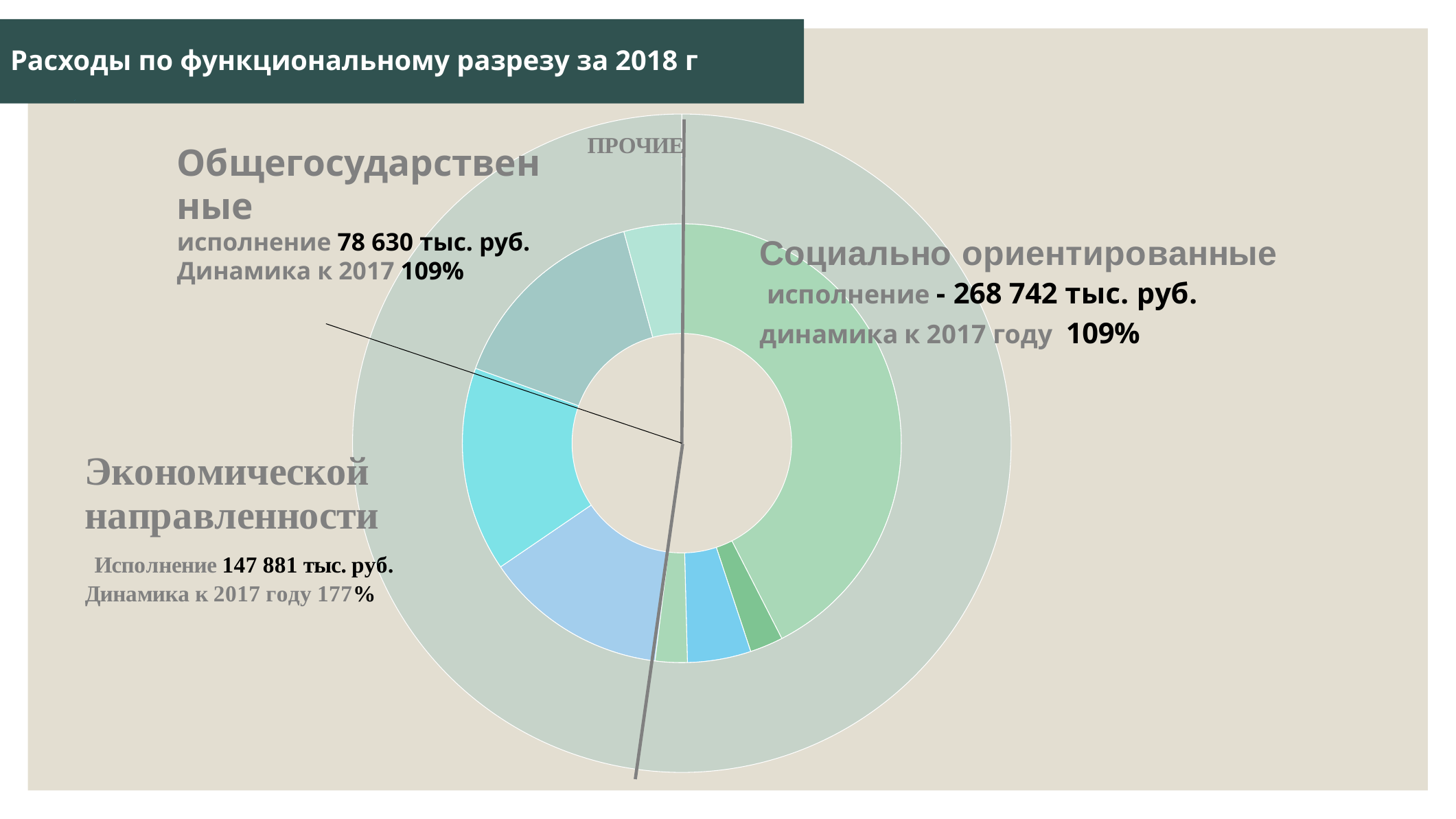
What is the execution value (Исполнение) for expenses of Экономической направленности? 147 881 тыс. руб. What is the dynamics relative to 2017 for Социально ориентированные expenses? 109% What is the execution value (исполнение) for Социально ориентированные expenses? 268 742 тыс. руб. Which of the three labeled expense groups with printed values has the highest execution value? Социально ориентированные What is the dynamics relative to 2017 (Динамика к 2017 году) for expenses of Экономической направленности? 177% What is the title of the slide's chart? Расходы по функциональному разрезу за 2018 г What is the execution value (исполнение) for Общегосударственные expenses? 78 630 тыс. руб. How many expense groups are labeled around the chart? 4 What kind of chart is shown on the slide? doughnut (pie) chart Which of the three labeled expense groups with printed values has the lowest execution value? Общегосударственные What is the difference between the execution values for Социально ориентированные and Экономической направленности expenses? 120 861 тыс. руб. Which is larger: the execution value for Экономической направленности or for Общегосударственные? Экономической направленности